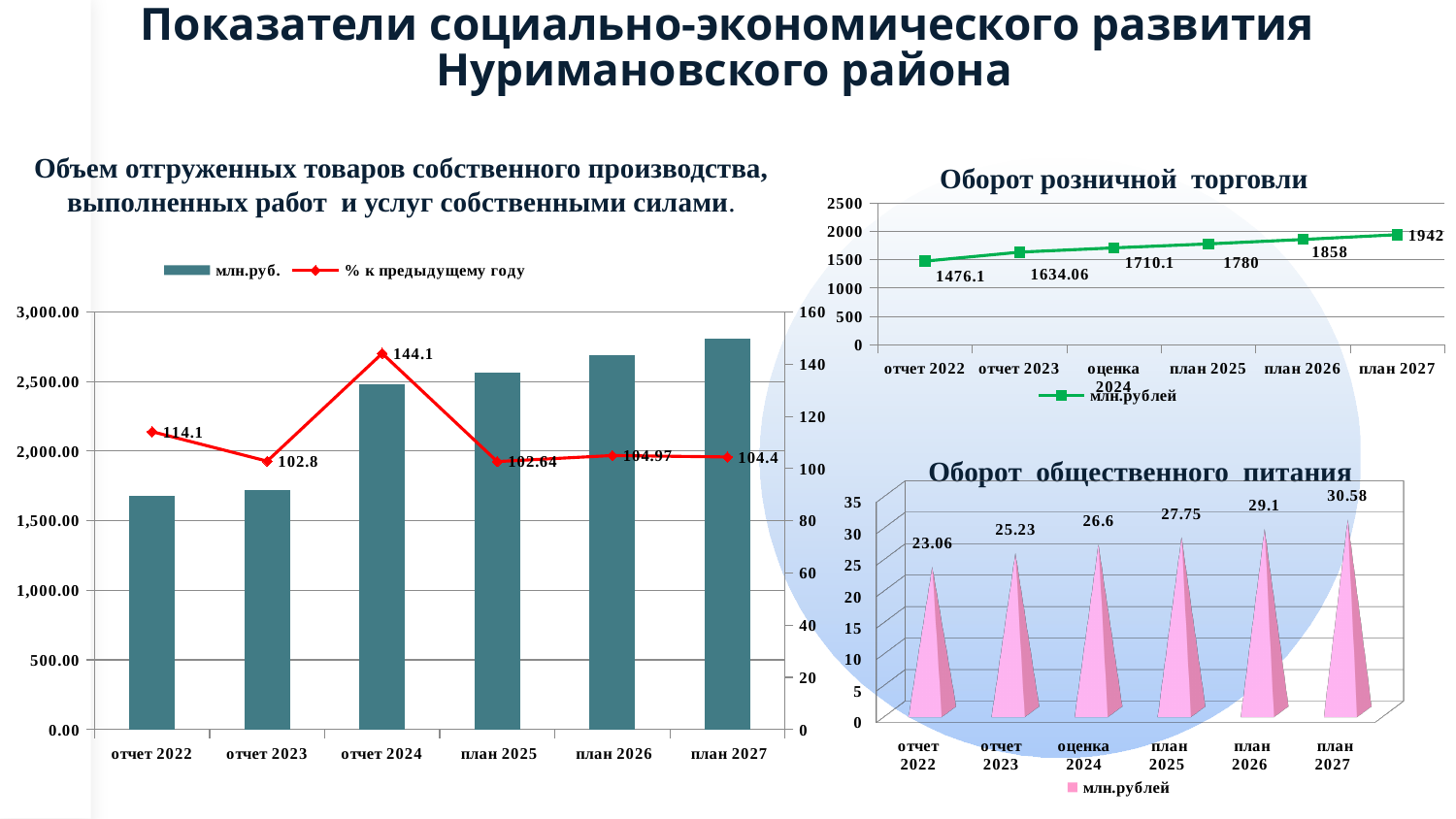
In the chart 'Оборот розничной торговли', do the values rise or fall from отчет 2022 to план 2027? rise In the chart 'Объем отгруженных товаров собственного производства, выполненных работ и услуг собственными силами', what is the value of '% к предыдущему году' for отчет 2024? 144.1 In the chart 'Объем отгруженных товаров собственного производства, выполненных работ и услуг собственными силами', is the 'млн.руб.' bar for план 2027 greater or less than 2,500.00? greater In the chart 'Оборот розничной торговли', what is the value for план 2027? 1942 In the chart 'Объем отгруженных товаров собственного производства, выполненных работ и услуг собственными силами', what is the difference between the '% к предыдущему году' values for отчет 2024 and отчет 2022? 30 How many categories are shown on the x axis of the chart 'Оборот розничной торговли'? 6 What kind of chart is 'Оборот розничной торговли'? line chart How many series does the legend of the chart 'Объем отгруженных товаров собственного производства, выполненных работ и услуг собственными силами' list? 2 In the chart 'Оборот общественного питания', what is the difference between the values for план 2027 and отчет 2022? 7.52 In the chart 'Оборот общественного питания', what is the value for оценка 2024? 26.6 In the chart 'Объем отгруженных товаров собственного производства, выполненных работ и услуг собственными силами', is the 'млн.руб.' bar for отчет 2022 greater or less than 2,000.00? less In the chart 'Объем отгруженных товаров собственного производства, выполненных работ и услуг собственными силами', which category has the highest value of '% к предыдущему году'? отчет 2024